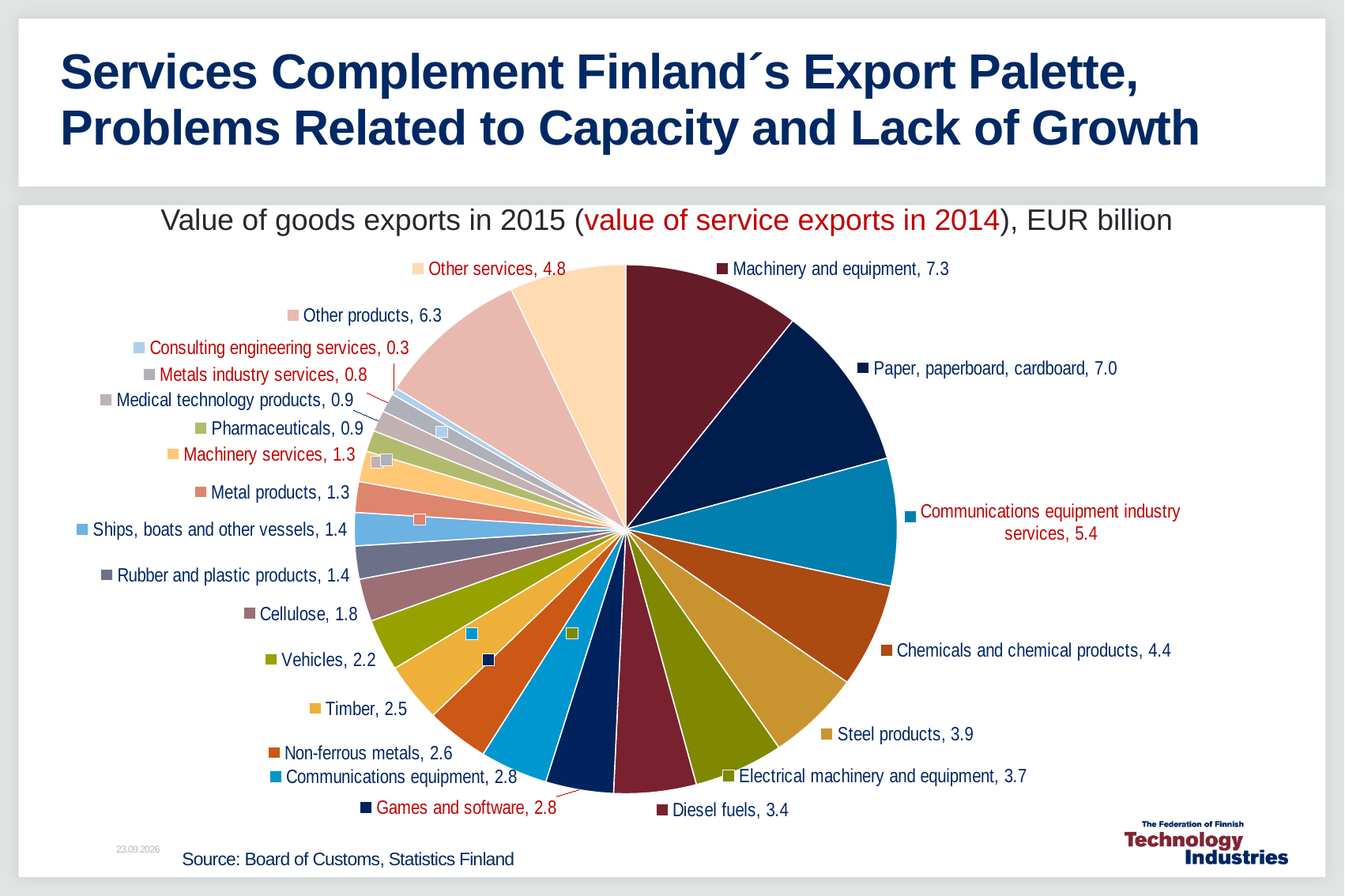
Which category has the smallest value in the pie chart? Consulting engineering services What kind of chart is shown on the slide? Pie chart What is the difference between the values for Machinery and equipment and Paper, paperboard, cardboard? 0.3 How many categories are shown in the pie chart? 23 What is the value for Diesel fuels? 3.4 What is the value for Communications equipment industry services? 5.4 What is the difference between the values for Other products and Other services? 1.5 Which is larger, Steel products or Diesel fuels? Steel products What is the value for Machinery and equipment? 7.3 What unit is stated in the chart title for the values? EUR billion What is the value for Consulting engineering services? 0.3 Which category has the largest value in the pie chart? Machinery and equipment